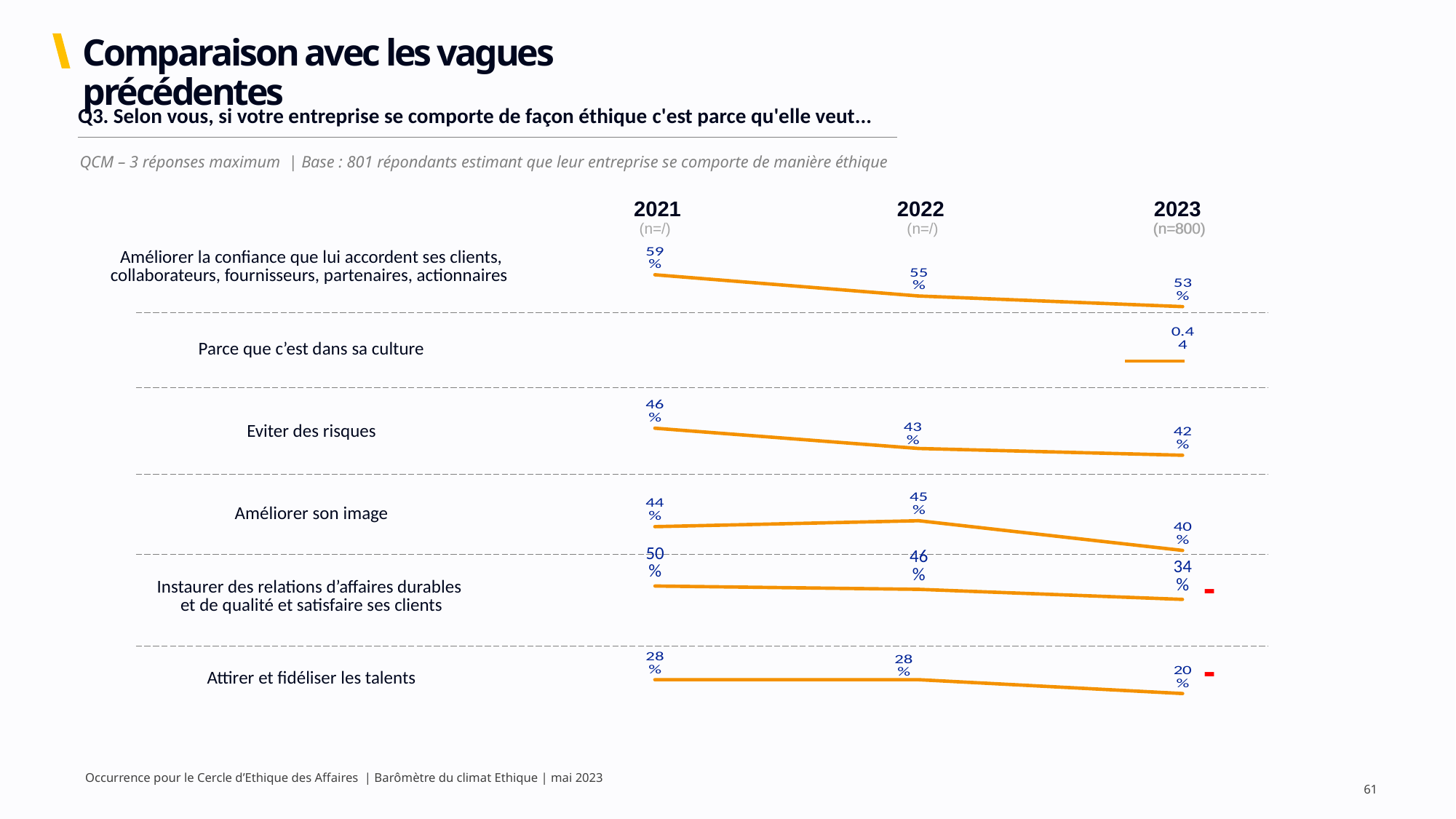
In the 'Améliorer la confiance que lui accordent ses clients, collaborateurs, fournisseurs, partenaires, actionnaires' chart, what is the value for 2021? 59% In the 'Attirer et fidéliser les talents' chart, what is the value for 2023? 20% In the 'Attirer et fidéliser les talents' chart, is the 2021 value larger than, smaller than, or equal to the 2022 value? equal In the 'Instaurer des relations d'affaires durables et de qualité et satisfaire ses clients' chart, what is the value for 2022? 46% What kind of chart is used in the 'Améliorer son image' row? line chart In the 'Améliorer la confiance que lui accordent ses clients, collaborateurs, fournisseurs, partenaires, actionnaires' chart, what is the value for 2023? 53% In the 'Eviter des risques' chart, do the values rise or fall from 2021 to 2023? fall In the 'Eviter des risques' chart, what is the value for 2022? 43% In the 'Améliorer son image' chart, which year has the highest value? 2022 How many years (data points) are plotted in the 'Eviter des risques' chart? 3 In the 'Instaurer des relations d'affaires durables et de qualité et satisfaire ses clients' chart, what is the difference between the 2021 and 2023 values? 16% In the 'Améliorer son image' chart, which year has the lowest value? 2023